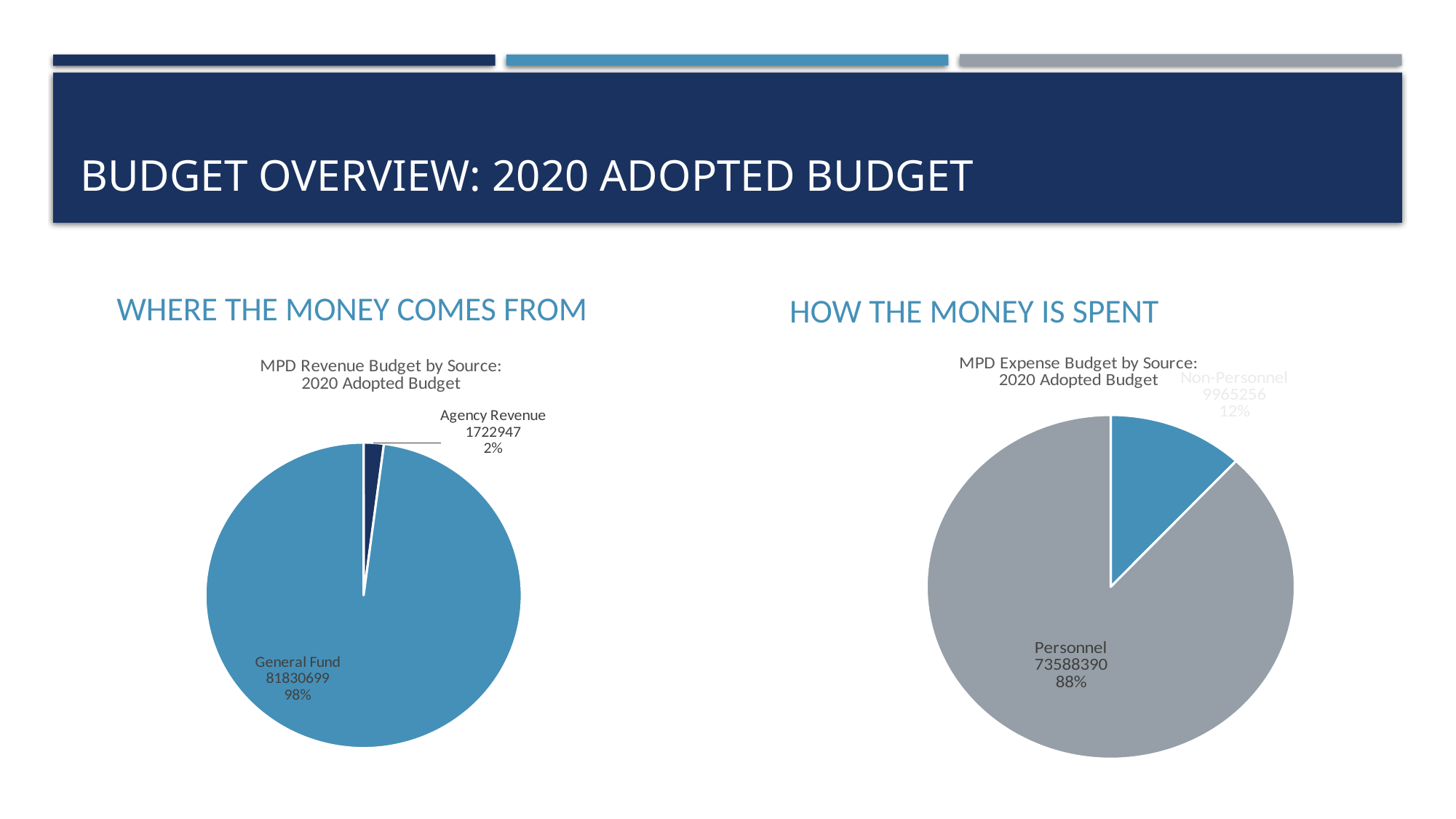
In the 'MPD Expense Budget by Source' chart, which category is the smallest? Non-Personnel In the 'MPD Revenue Budget by Source' chart, what share of the pie is Agency Revenue? 2% In the 'MPD Expense Budget by Source' chart, what is the difference between the Personnel and Non-Personnel values? 63623134 In the 'MPD Expense Budget by Source: 2020 Adopted Budget' chart, what is the value for Personnel? 73588390 What type of chart is the 'MPD Revenue Budget by Source: 2020 Adopted Budget' chart? Pie chart In the 'MPD Revenue Budget by Source' chart, what is the value for General Fund? 81830699 How many slices does the 'MPD Revenue Budget by Source' pie chart have? 2 In the 'MPD Revenue Budget by Source' chart, which category is the largest? General Fund In the 'MPD Expense Budget by Source' chart, what is the value for Non-Personnel? 9965256 In the 'MPD Revenue Budget by Source' chart, what share of the pie is General Fund? 98% In the 'MPD Revenue Budget by Source' chart, what is the value for Agency Revenue? 1722947 In the 'MPD Expense Budget by Source' chart, what share of the pie is Personnel? 88%